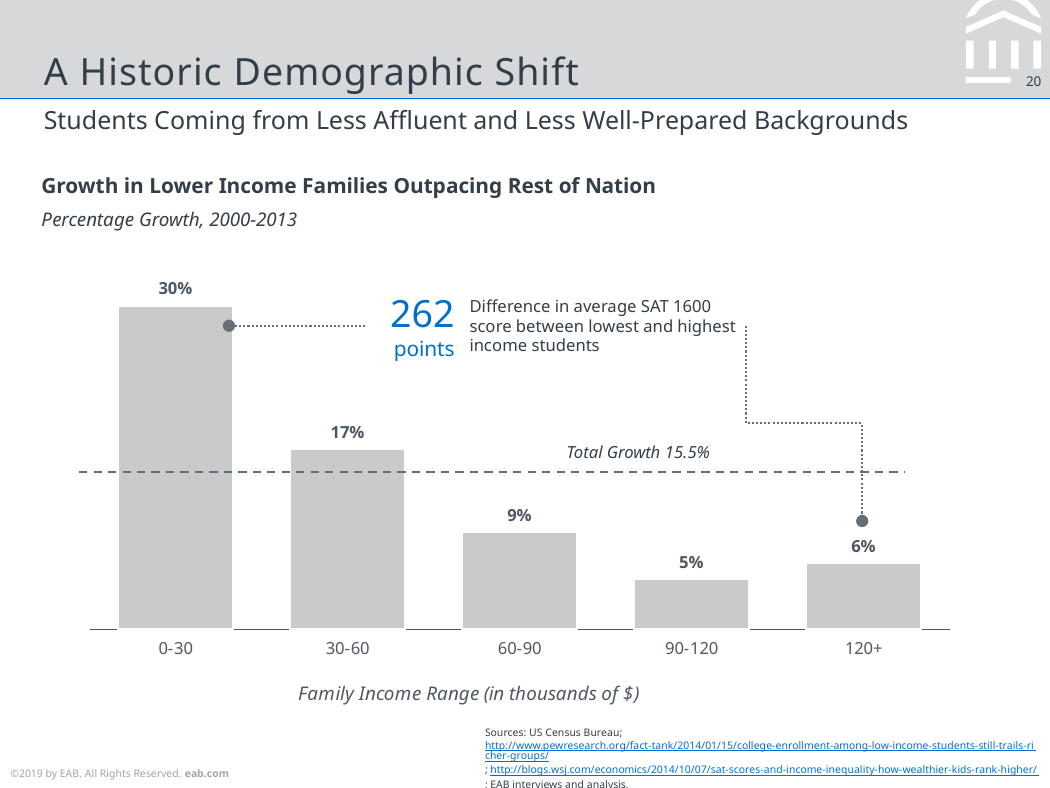
What kind of chart is used to show percentage growth by family income range? Bar chart What total growth value is marked by the dashed line on the chart? 15.5% What is the percentage growth for the 0-30 family income range? 30% Which family income range has the highest percentage growth? 0-30 How many family income ranges are shown in the chart? 5 Which has higher percentage growth, the 60-90 range or the 120+ range? 60-90 What is the difference in percentage growth between the 0-30 and 30-60 income ranges? 13 percentage points Which family income range has the lowest percentage growth? 90-120 Do the percentage growth values generally rise or fall as family income range increases from 0-30 to 90-120? Fall What is the percentage growth for the 90-120 family income range? 5% What is the x-axis label of the chart? Family Income Range (in thousands of $) What is the percentage growth for the 120+ family income range? 6%